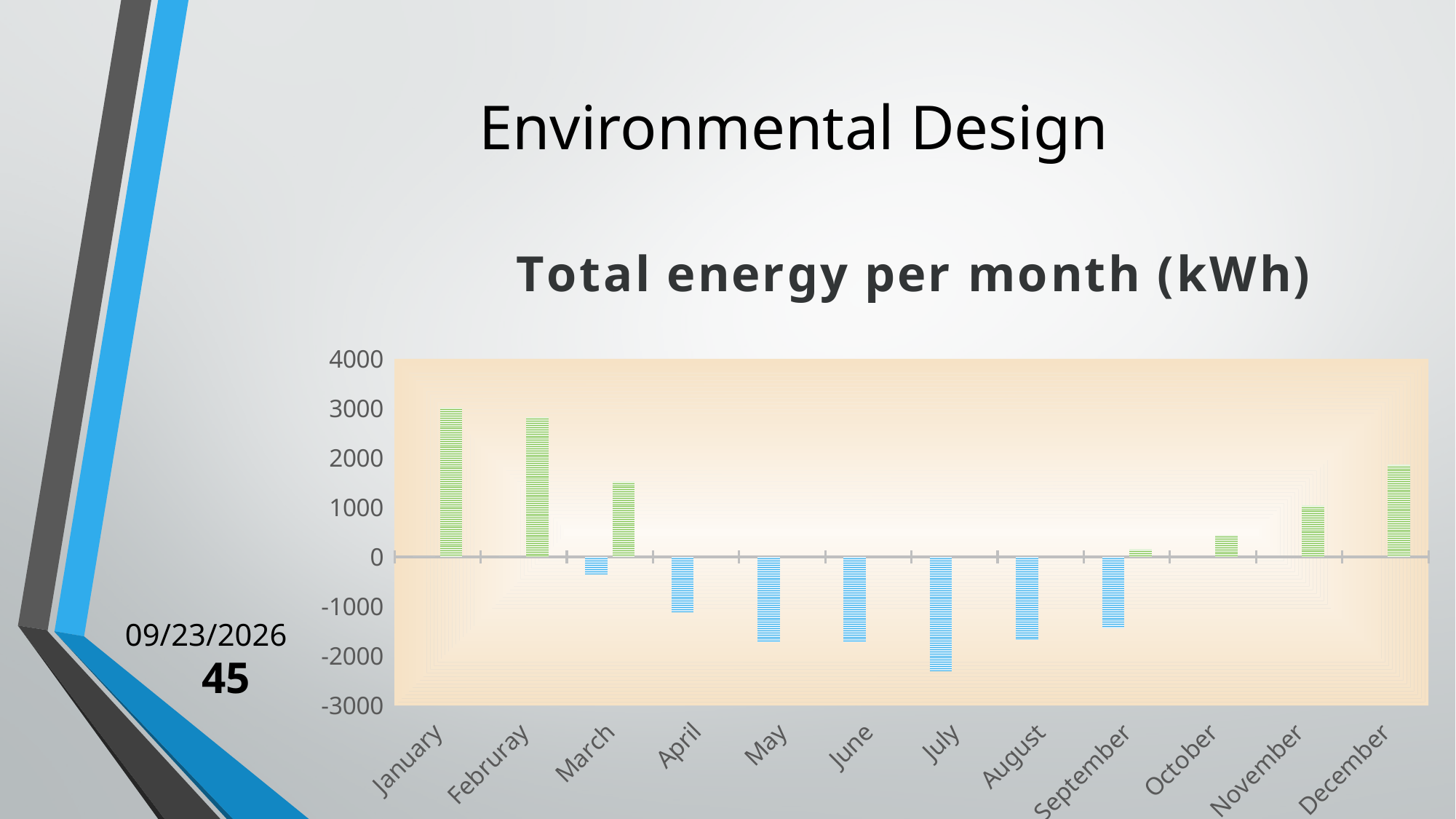
What kind of chart is shown on the slide? bar chart Which is larger, the value for Februray or the value for March? Februray What is the title of the chart? Total energy per month (kWh) Which month has the highest total energy value? January Is the value for July greater or less than -2000? less Is the value for December greater or less than 1000? greater Do the values rise or fall from January to March? fall Is the value for May greater or less than -1000? less Which month has the lowest total energy value? July How many months are plotted on the x axis of the chart? 12